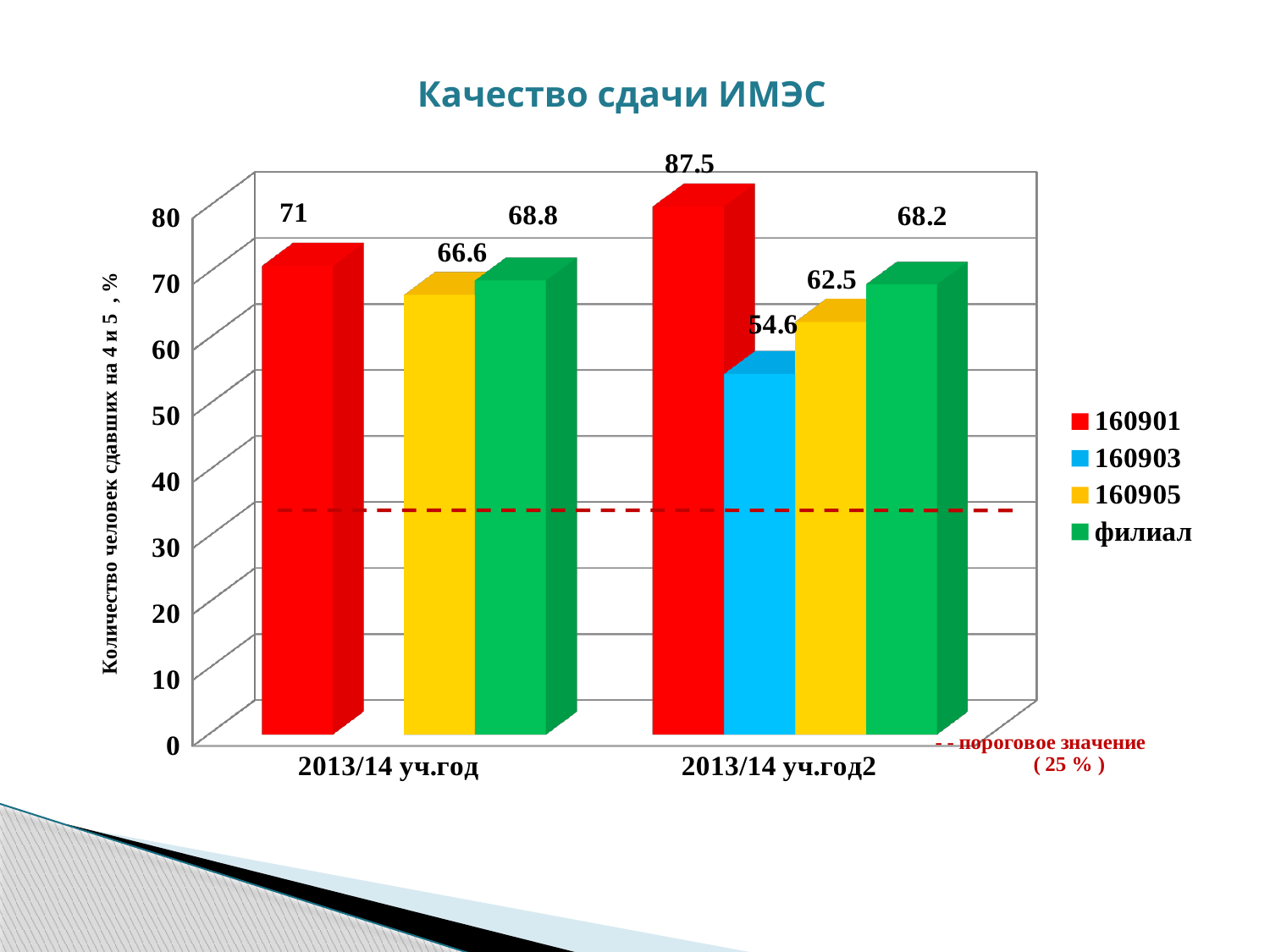
Which is larger: the value for 160905 in 2013/14 уч.год or the value for 160905 in 2013/14 уч.год2? 2013/14 уч.год What is the value for 160901 in the 2013/14 уч.год category? 71 What kind of chart is shown on the slide? Bar chart What is the difference between the 160901 values in 2013/14 уч.год2 and 2013/14 уч.год? 16.5 What is the value for 160903 in the 2013/14 уч.год2 category? 54.6 Which series has the lowest value in the 2013/14 уч.год2 category? 160903 What is the value for филиал in the 2013/14 уч.год category? 68.8 Which series has the highest value in the 2013/14 уч.год2 category? 160901 How many series does the legend list? 4 What is the value for 160905 in the 2013/14 уч.год2 category? 62.5 What is the title of the chart? Качество сдачи ИМЭС How many categories are shown on the x axis? 2